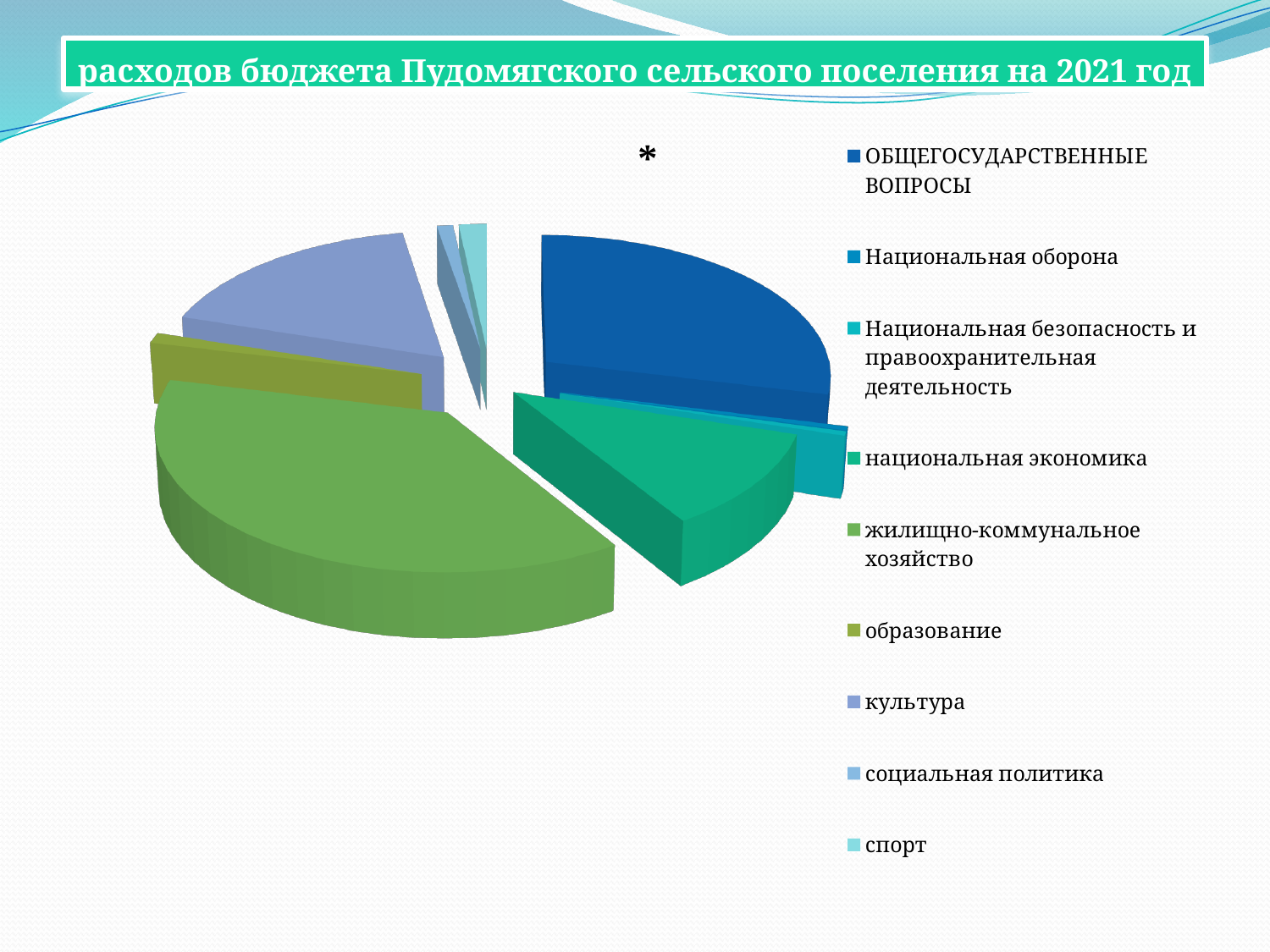
How many categories does the legend of the pie chart list? 9 Which slice is larger: жилищно-коммунальное хозяйство or ОБЩЕГОСУДАРСТВЕННЫЕ ВОПРОСЫ? жилищно-коммунальное хозяйство What colour is the slice for жилищно-коммунальное хозяйство in the pie chart? green Which category has the largest slice of the pie chart? жилищно-коммунальное хозяйство Which category is listed first in the legend of the pie chart? ОБЩЕГОСУДАРСТВЕННЫЕ ВОПРОСЫ Which slice is larger: ОБЩЕГОСУДАРСТВЕННЫЕ ВОПРОСЫ or Национальная оборона? ОБЩЕГОСУДАРСТВЕННЫЕ ВОПРОСЫ Which slice is larger: культура or спорт? культура What kind of chart is shown on the slide? pie chart